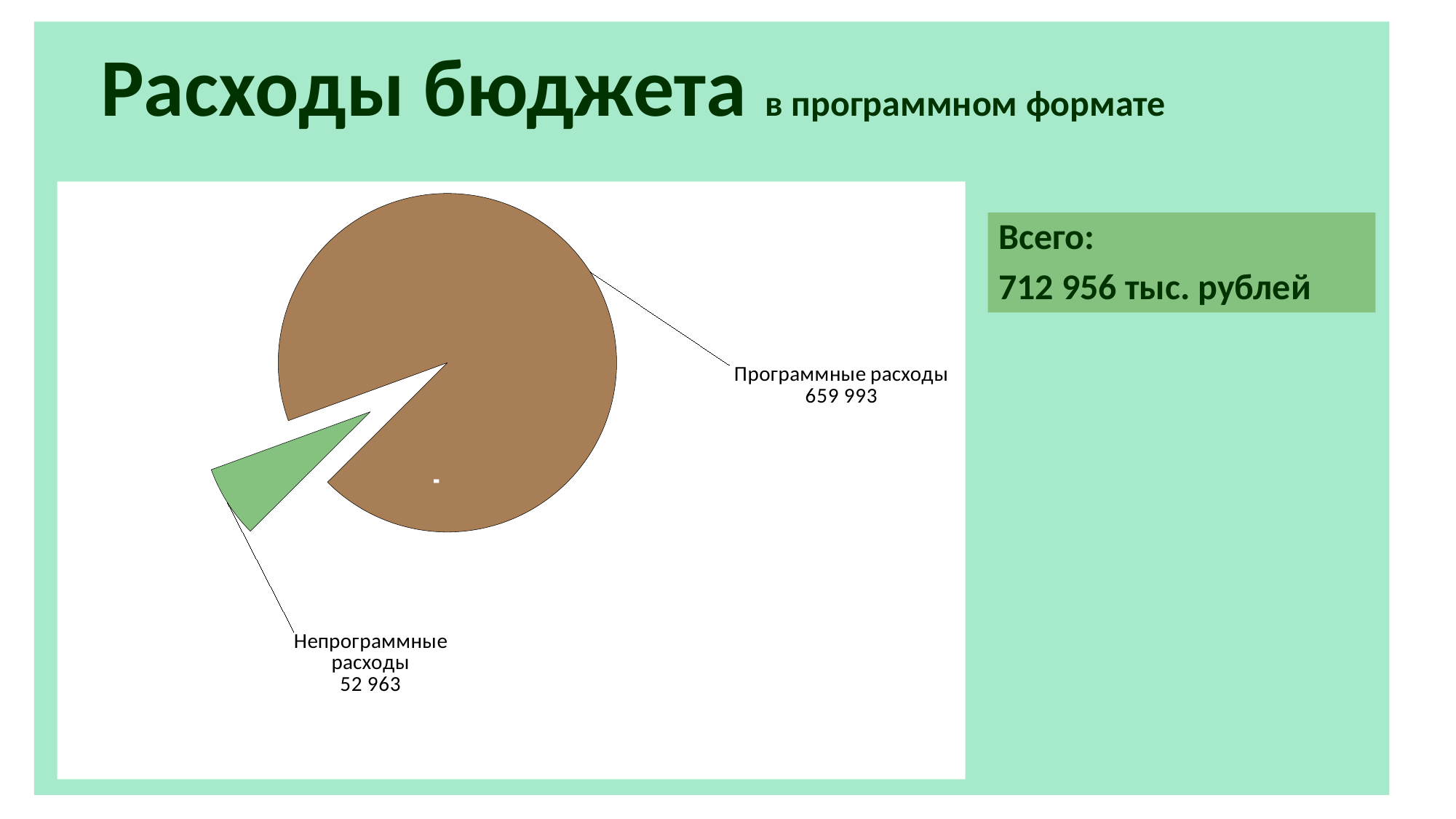
Is the value for Непрограммные расходы greater or less than 100 000? less Which category has the smallest slice of the pie? Непрограммные расходы What is the value for Непрограммные расходы? 52 963 What total is stated in the box to the right of the chart? 712 956 тыс. рублей What is the total of the two slices in the pie chart? 712 956 What colour is the slice for Непрограммные расходы? Green What kind of chart is shown on the slide? Pie chart What is the difference between Программные расходы and Непрограммные расходы? 607 030 What is the value for Программные расходы? 659 993 Which is larger, Программные расходы or Непрограммные расходы? Программные расходы How many slices does the pie chart have? 2 Which category has the largest slice of the pie? Программные расходы